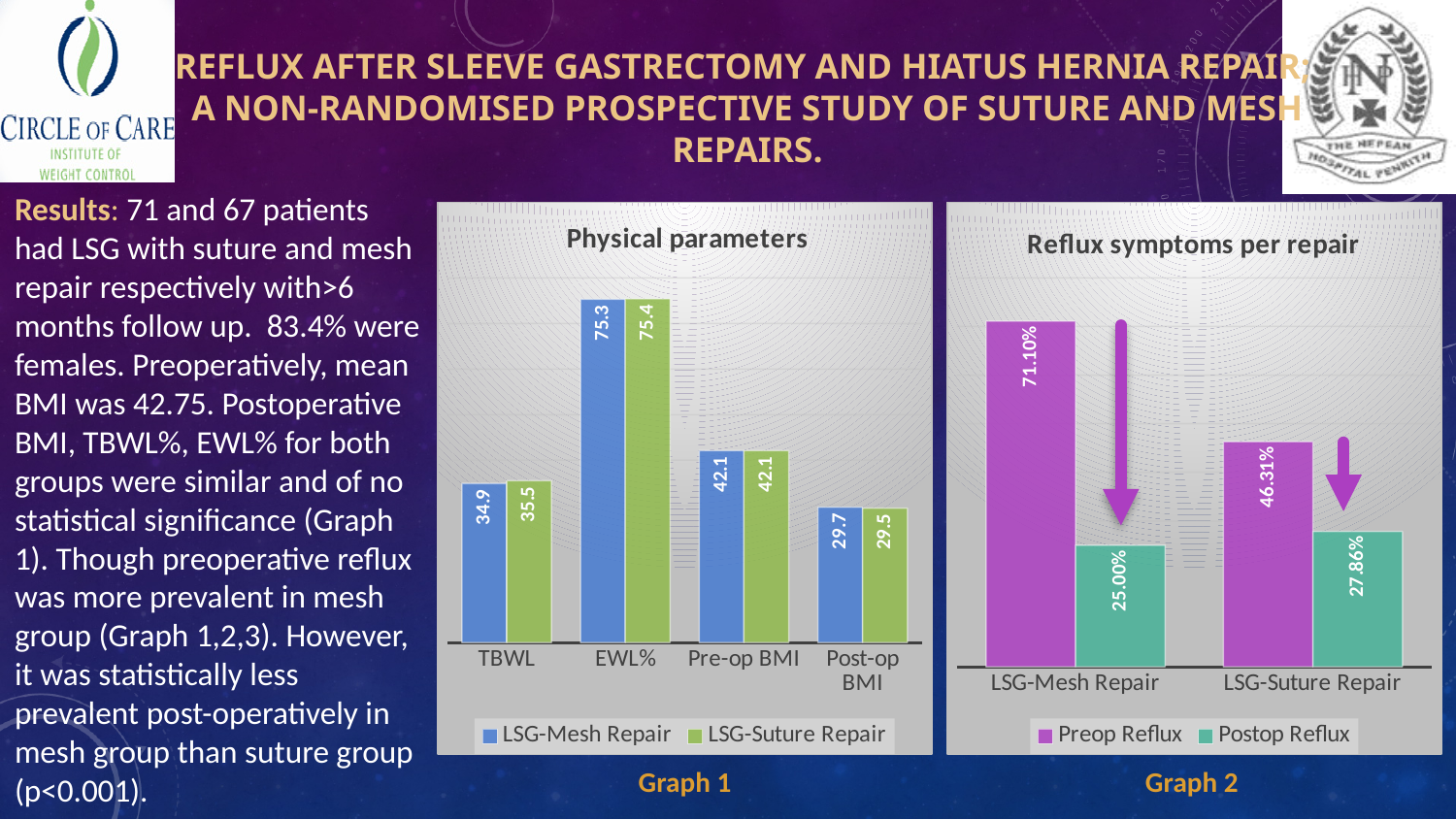
In the 'Reflux symptoms per repair' chart, how many series does the legend list? 2 In the 'Physical parameters' chart, what is the difference between the Pre-op BMI and Post-op BMI for LSG-Suture Repair? 12.6 In the 'Reflux symptoms per repair' chart, what is the difference between Preop Reflux and Postop Reflux for LSG-Mesh Repair? 46.10% In the 'Reflux symptoms per repair' chart, what is the Preop Reflux value for LSG-Mesh Repair? 71.10% In the 'Reflux symptoms per repair' chart, which repair group has the lower Postop Reflux value? LSG-Mesh Repair What type of chart is the 'Reflux symptoms per repair' chart? Bar chart In the 'Physical parameters' chart, what is the TBWL value for LSG-Suture Repair? 35.5 In the 'Reflux symptoms per repair' chart, what is the Postop Reflux value for LSG-Suture Repair? 27.86% In the 'Physical parameters' chart, what is the Post-op BMI for LSG-Mesh Repair? 29.7 In the 'Physical parameters' chart, how many categories are shown on the x axis? 4 In the 'Physical parameters' chart, which category has the highest values for both series? EWL% In the 'Physical parameters' chart, what is the EWL% value for LSG-Mesh Repair? 75.3